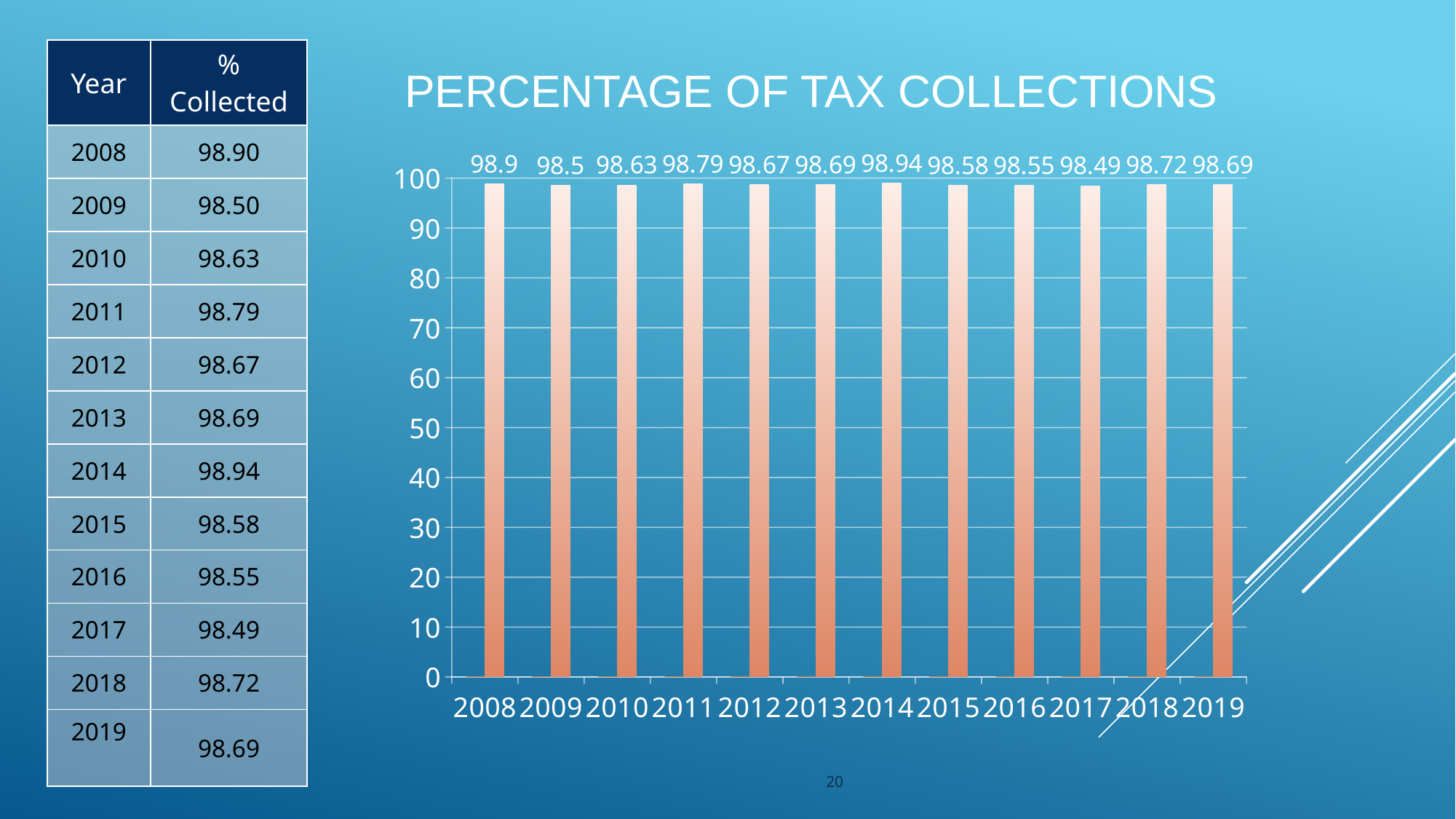
What is the difference between the values for 2008 and 2009? 0.4 What kind of chart is shown on the slide? bar chart What is the value shown for 2019? 98.69 What is the difference between the values for 2014 and 2017? 0.45 What is the value shown for 2008? 98.9 How many years are plotted on the chart? 12 Which year has the lowest value according to the data labels? 2017 What is the value shown for 2017? 98.49 What is the value shown for 2014? 98.94 Which is larger according to the data labels, the value for 2011 or the value for 2016? 2011 Which year has the highest value according to the data labels? 2014 Is the value for 2012 greater or less than 90? greater